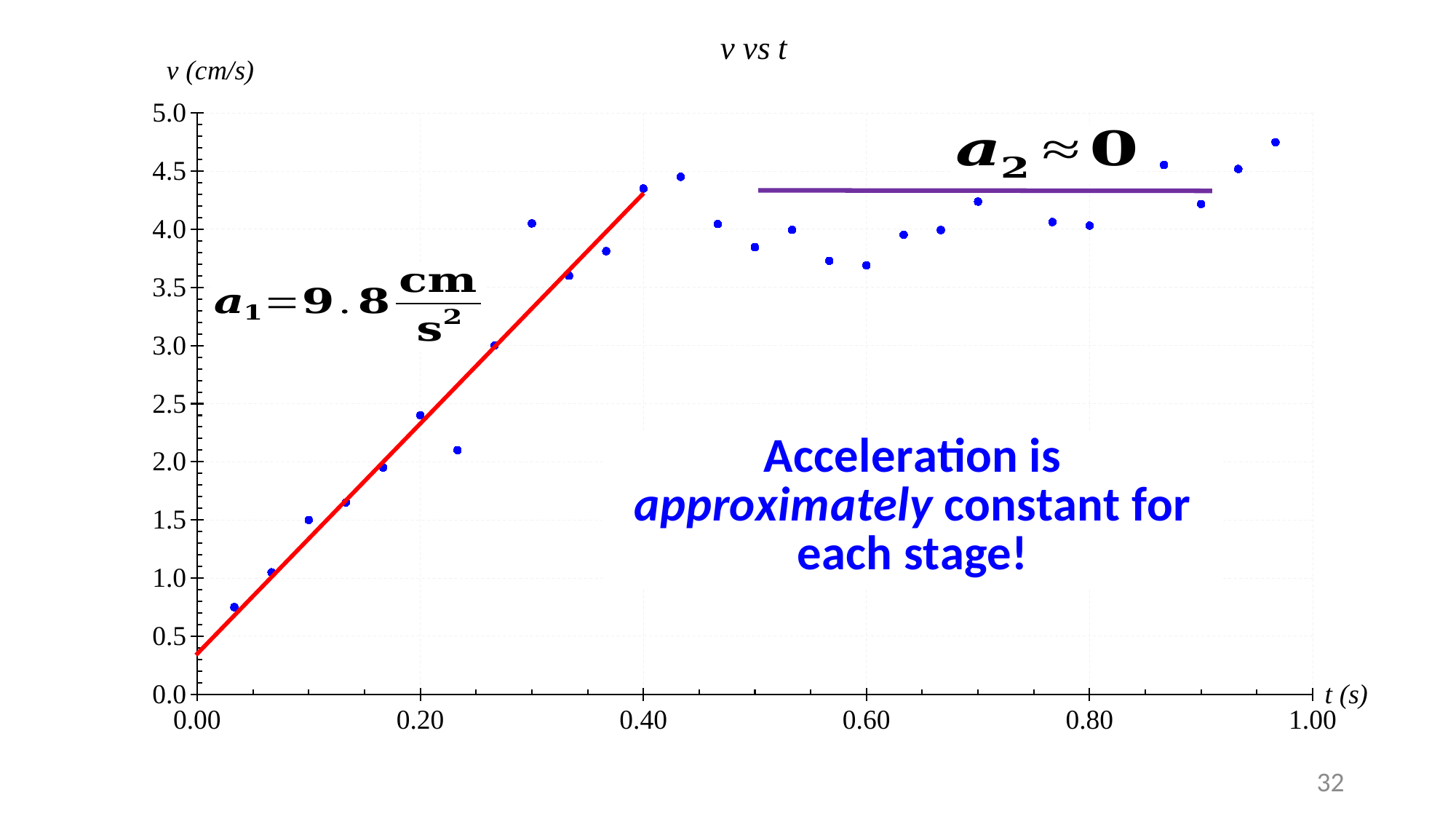
What kind of chart is shown on the slide? scatter plot Between t = 0.00 s and t = 0.40 s, do the plotted velocities rise or fall as t increases? rise What is the title of the chart? v vs t Is the plotted velocity at t = 0.20 s greater or less than 3.0 cm/s? less Which has the larger plotted velocity: the point at t = 0.20 s or the point at t = 0.80 s? t = 0.80 s Is the plotted velocity at t = 0.10 s greater or less than 2.0 cm/s? less According to the annotation on the chart, what is the value of a1? 9.8 cm/s² Is the plotted velocity at t = 0.40 s greater or less than 4.0 cm/s? greater Which has the larger plotted velocity: the point at t = 0.40 s or the point at t = 0.60 s? t = 0.40 s Does the highest plotted velocity occur before or after t = 0.80 s? after